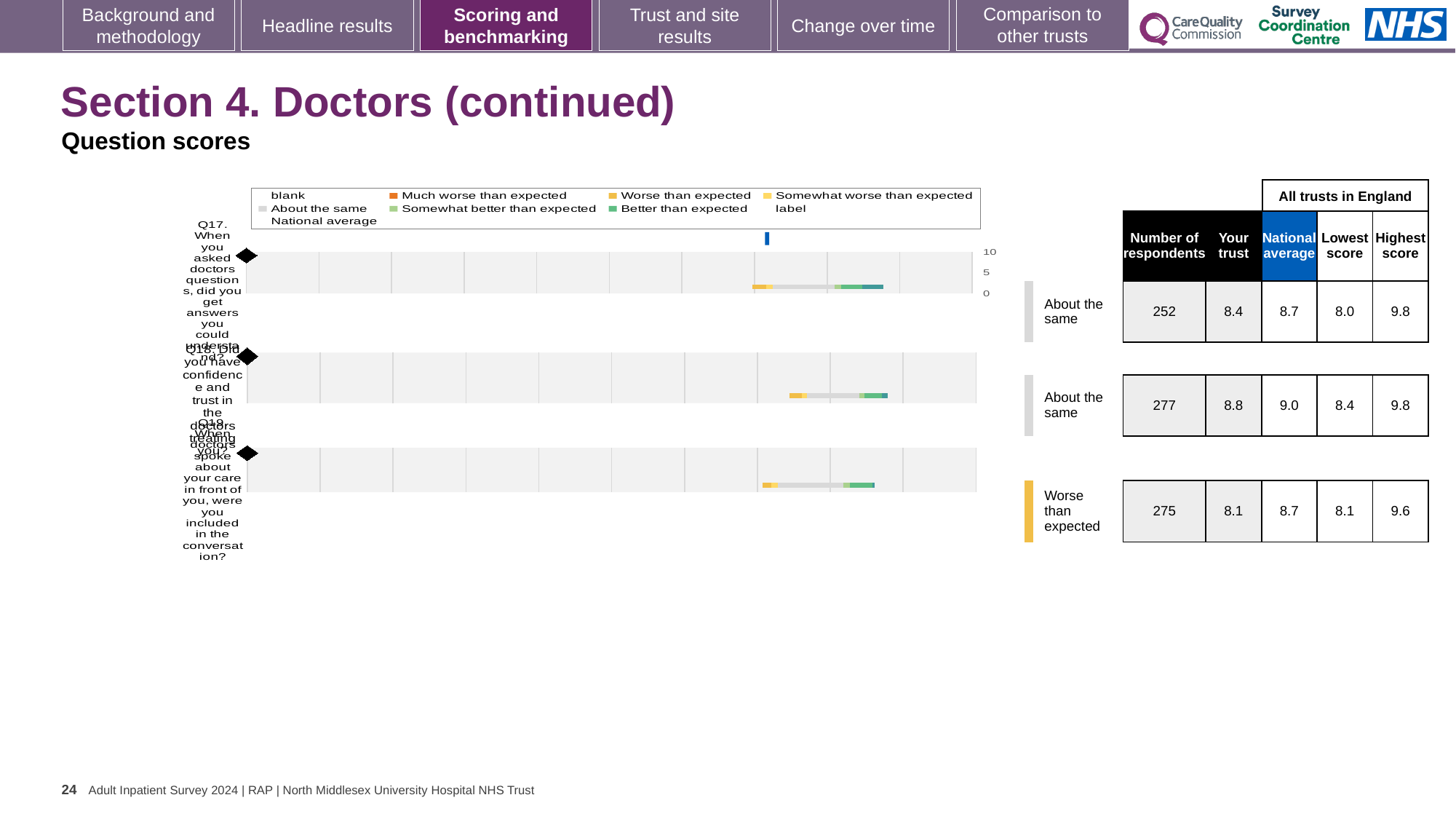
What benchmark category is shown for Q19? Worse than expected What is the national average score for Q18 (Did you have confidence and trust in the doctors treating you)? 9.0 How many questions are plotted on the chart? 3 What is the lowest score among all trusts in England for Q18? 8.4 How many respondents answered Q19 (When doctors spoke about your care in front of you, were you included in the conversation)? 275 Which is larger for Q17: the 'Your trust' score or the national average? National average What is the highest score among all trusts in England for Q19? 9.6 Which question has the highest 'Your trust' score? Q18 Which question has the lowest 'Your trust' score? Q19 What is the 'Your trust' score for Q17 (When you asked doctors questions, did you get answers you could understand)? 8.4 What is the difference between the national average and the 'Your trust' score for Q19? 0.6 What kind of chart is shown on the slide? Bar chart